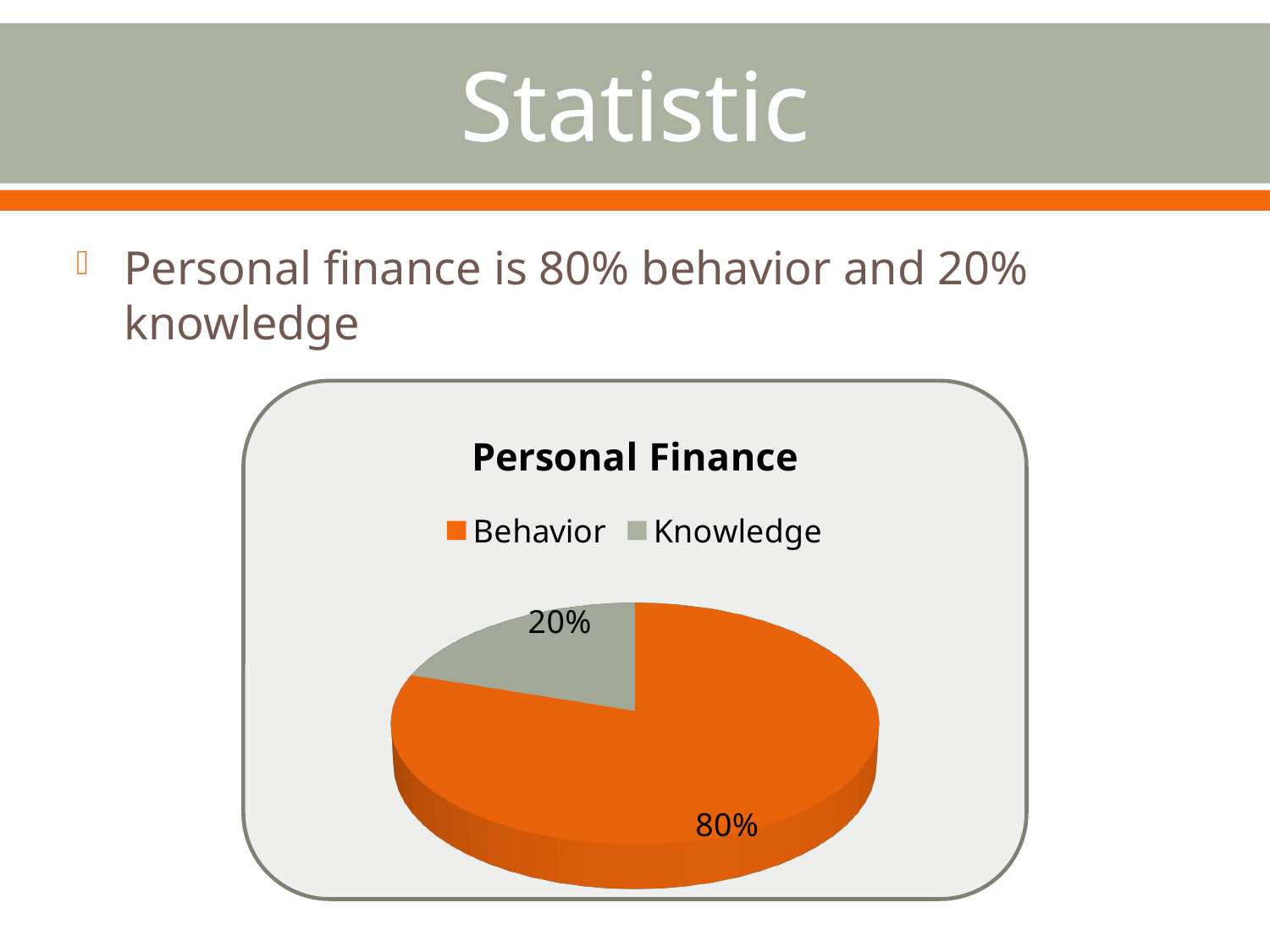
What is the total of the two slices shown in the pie chart? 100% What share of the pie does Behavior take? 80% Which slice of the pie is the largest? Behavior What is the title of the chart? Personal Finance How many entries does the legend list? 2 What is the difference in percentage points between the Behavior and Knowledge slices? 60 How many slices does the pie chart have? 2 Which is larger, the Behavior slice or the Knowledge slice? Behavior What share of the pie does Knowledge take? 20% What colour is the Behavior slice? orange What kind of chart is shown on the slide? pie chart Which slice of the pie is the smallest? Knowledge